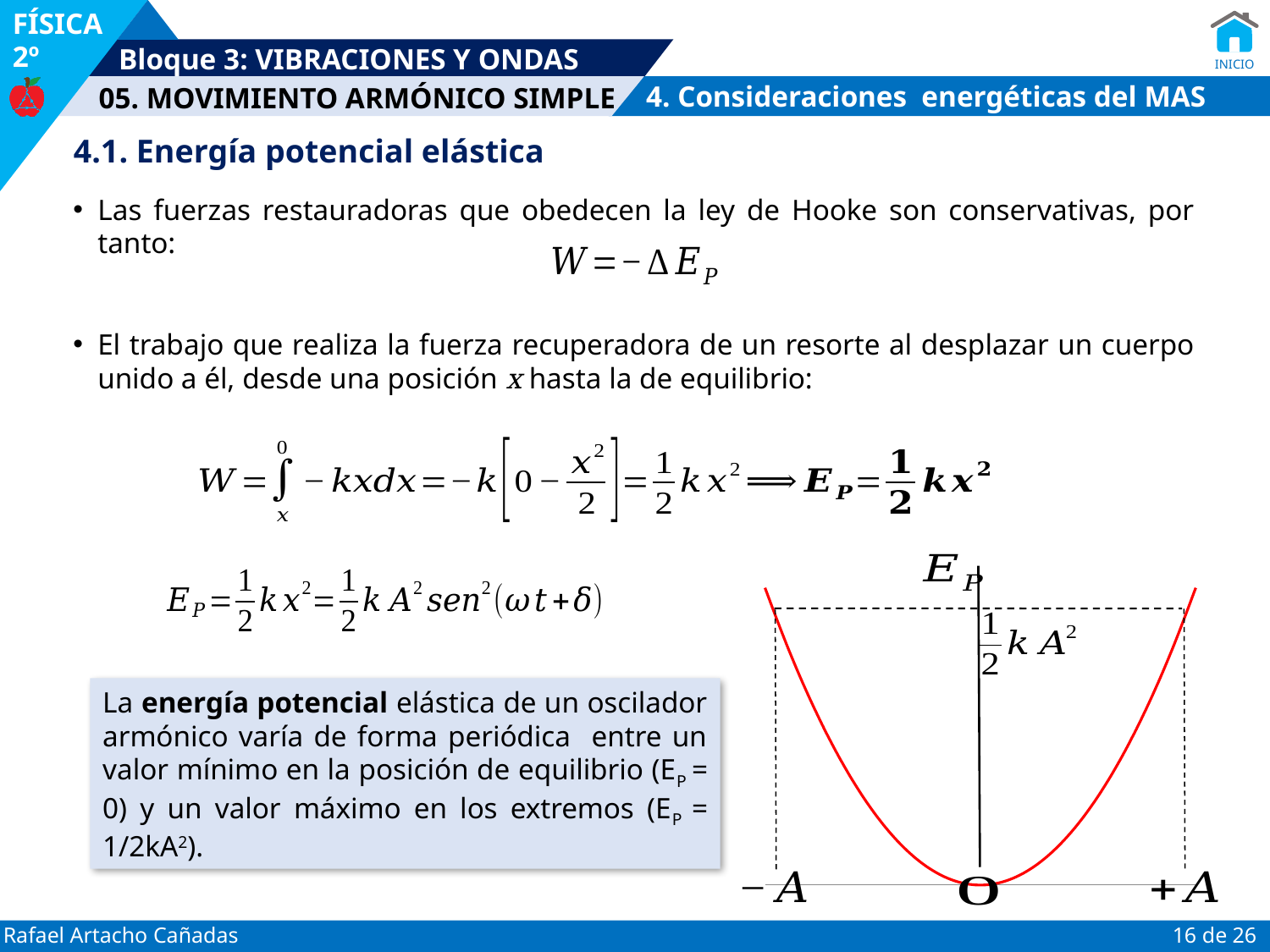
In the graph at the bottom right, is the value of E_P at +A larger or smaller than at O? larger In the graph at the bottom right, at which labelled position on the horizontal axis does the curve reach its minimum? O In the graph at the bottom right, what value does the dashed horizontal line at the top of the curve mark? 1/2 kA² In the graph at the bottom right, at which labelled positions on the horizontal axis does the curve reach its maximum value? -A and +A In the graph at the bottom right, does the curve rise or fall as x goes from -A to O? fall According to the slide, what is the value of E_P at the equilibrium position O? 0 In the graph at the bottom right, does the curve rise or fall as x goes from O to +A? rise What colour is the curve in the graph at the bottom right of the slide? red What quantity is plotted on the vertical axis of the graph at the bottom right of the slide? E_P How many labelled positions are marked on the horizontal axis of the graph at the bottom right? 3